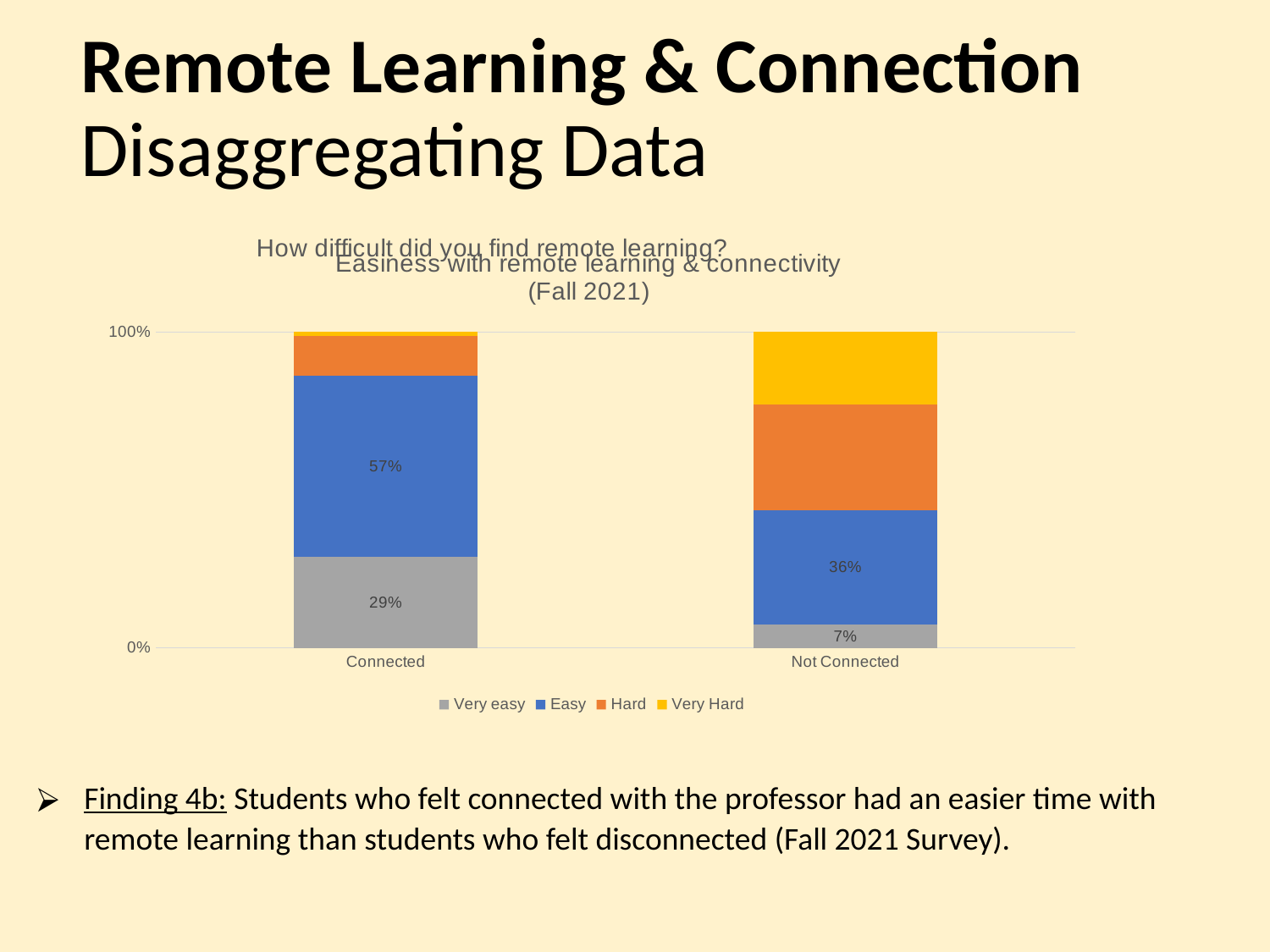
For Not Connected students, which is larger, the Easy share or the Very easy share? Easy How much larger is the Easy share for Connected students than for Not Connected students? 21% What percentage of Connected students found remote learning Very easy? 29% What percentage of Not Connected students found remote learning Very easy? 7% What percentage of Not Connected students found remote learning Easy? 36% Which response makes up the largest segment of the Connected bar? Easy Which group has the larger Very easy share, Connected or Not Connected? Connected How many series does the chart legend list? 4 How many categories are shown on the x axis of the chart? 2 What is the difference between the Very easy shares for Connected and Not Connected students? 22% What percentage of Connected students found remote learning Easy? 57% What kind of chart is shown on the slide? Stacked bar chart